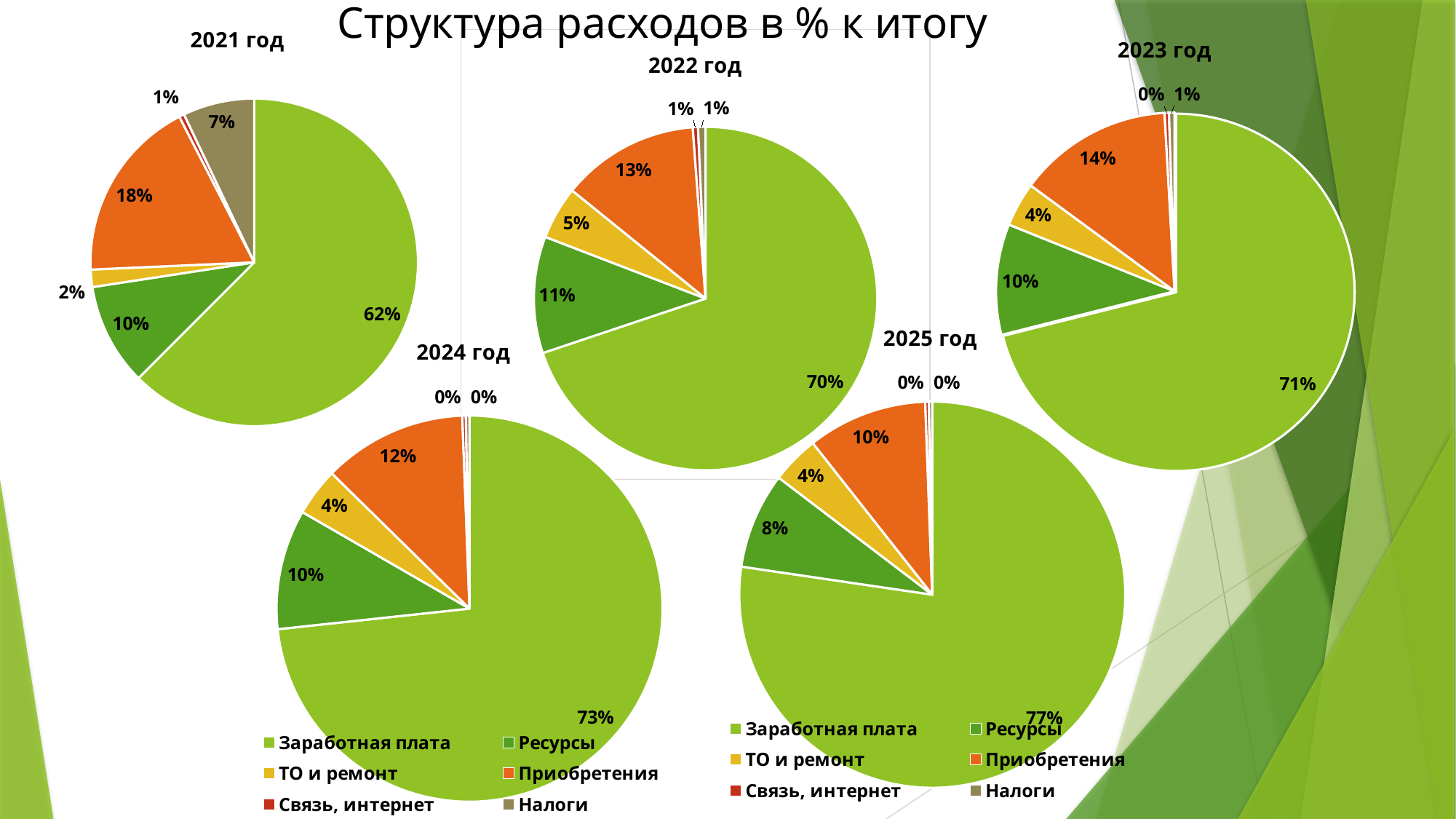
In the 2022 год pie chart, what share is Приобретения? 13% What is the difference between the Заработная плата share in 2025 год and in 2021 год? 15% In the 2024 год pie chart, which category has the largest share? Заработная плата In the 2022 год pie chart, what is the difference between Приобретения and ТО и ремонт? 8% In the 2023 год pie chart, what share is Ресурсы? 10% In the 2021 год pie chart, what share is Заработная плата? 62% What type of chart is used for 2023 год? Pie chart How many pie charts are shown on the slide? 5 How many categories does the legend list? 6 In the 2021 год pie chart, what share is Налоги? 7% In the 2021 год pie chart, which is larger, Приобретения or Ресурсы? Приобретения In the 2025 год pie chart, what share is Заработная плата? 77%